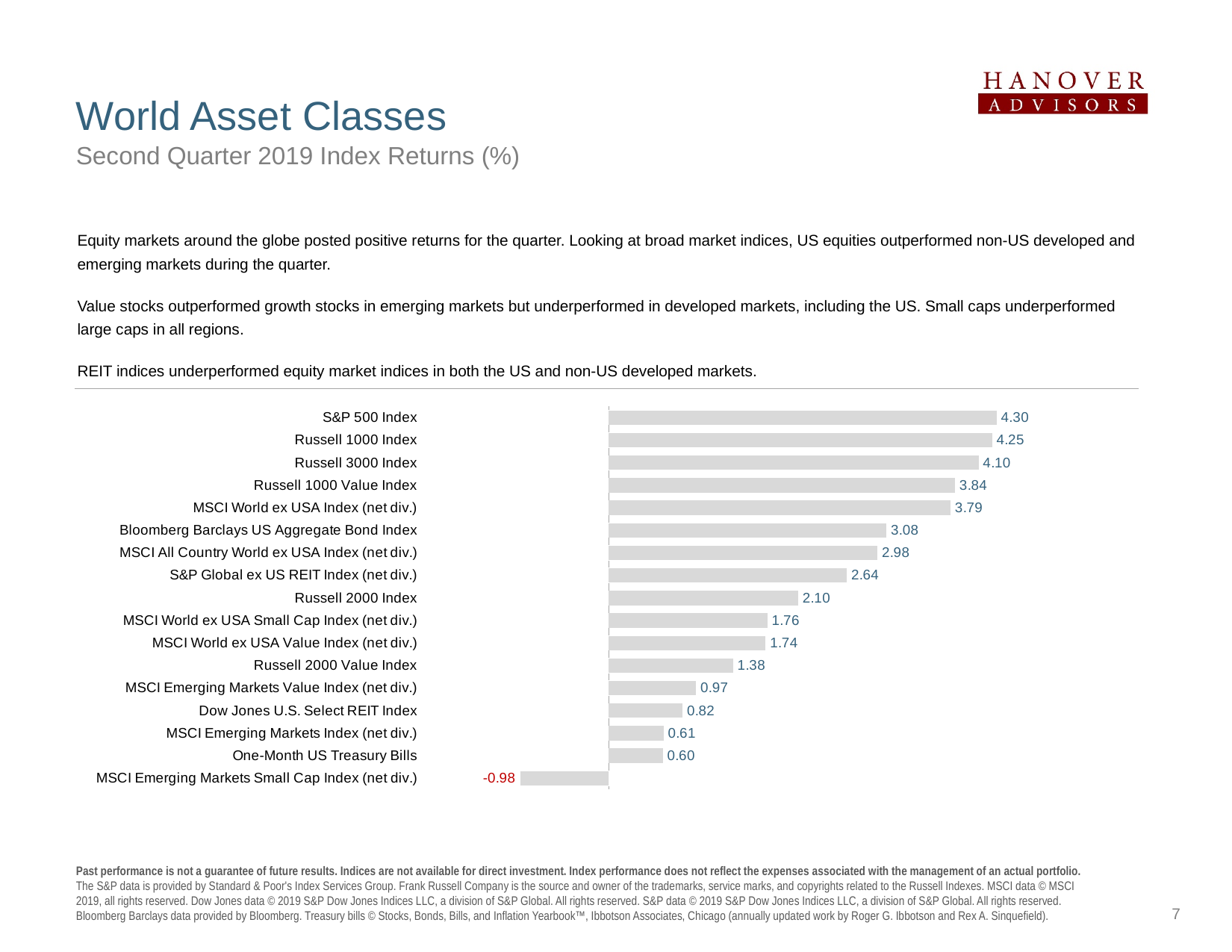
What kind of chart is shown on the slide? Bar chart What is the difference between the MSCI World ex USA Index (net div.) and the MSCI Emerging Markets Index (net div.)? 3.18 Which index has the highest value in the chart? S&P 500 Index What is the value for the Bloomberg Barclays US Aggregate Bond Index? 3.08 Which is larger, the MSCI Emerging Markets Value Index (net div.) or the MSCI Emerging Markets Index (net div.)? MSCI Emerging Markets Value Index (net div.) What is the difference between the Russell 1000 Index and the Russell 2000 Index? 2.15 What is the value for the MSCI Emerging Markets Small Cap Index (net div.)? -0.98 What is the value for the S&P 500 Index? 4.30 How many indices are shown in the chart? 17 What is the value for the Dow Jones U.S. Select REIT Index? 0.82 Which index has the lowest value in the chart? MSCI Emerging Markets Small Cap Index (net div.) Which is larger, the Russell 1000 Value Index or the S&P Global ex US REIT Index (net div.)? Russell 1000 Value Index